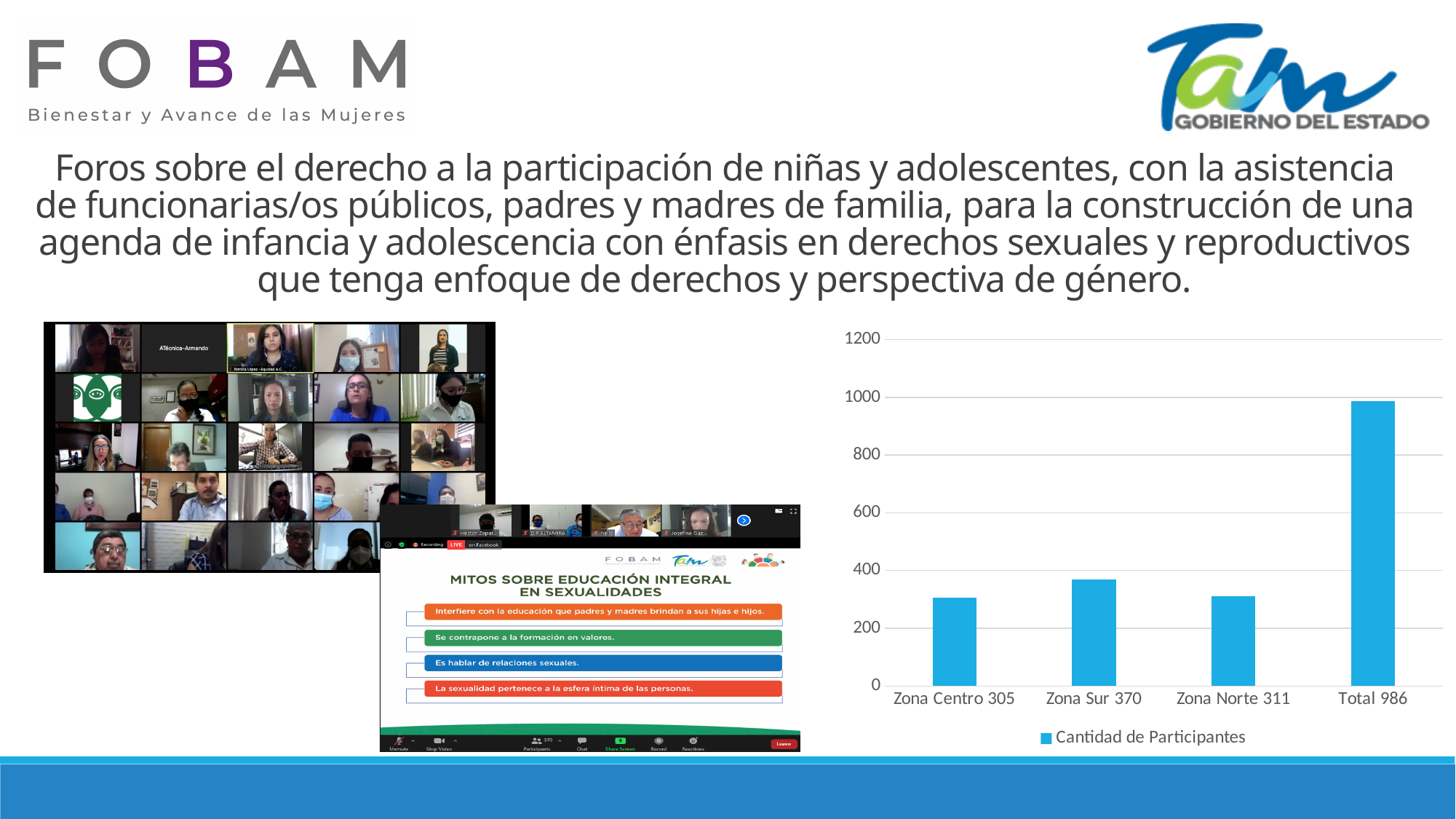
What is the number of participants for Zona Sur? 370 Among the three zones (Centro, Sur, Norte), which has the highest number of participants? Zona Sur What is the number of participants for Zona Centro? 305 What kind of chart is shown on the slide? bar chart What is the number of participants for Zona Norte? 311 What is the value shown for the Total bar? 986 How many series does the chart legend list? 1 Among the three zones (Centro, Sur, Norte), which has the lowest number of participants? Zona Centro How many categories are plotted in the bar chart? 4 What is the difference in participants between Zona Sur and Zona Centro? 65 Is the value for Zona Sur greater or less than 400? less What is the name of the series shown in the chart legend? Cantidad de Participantes